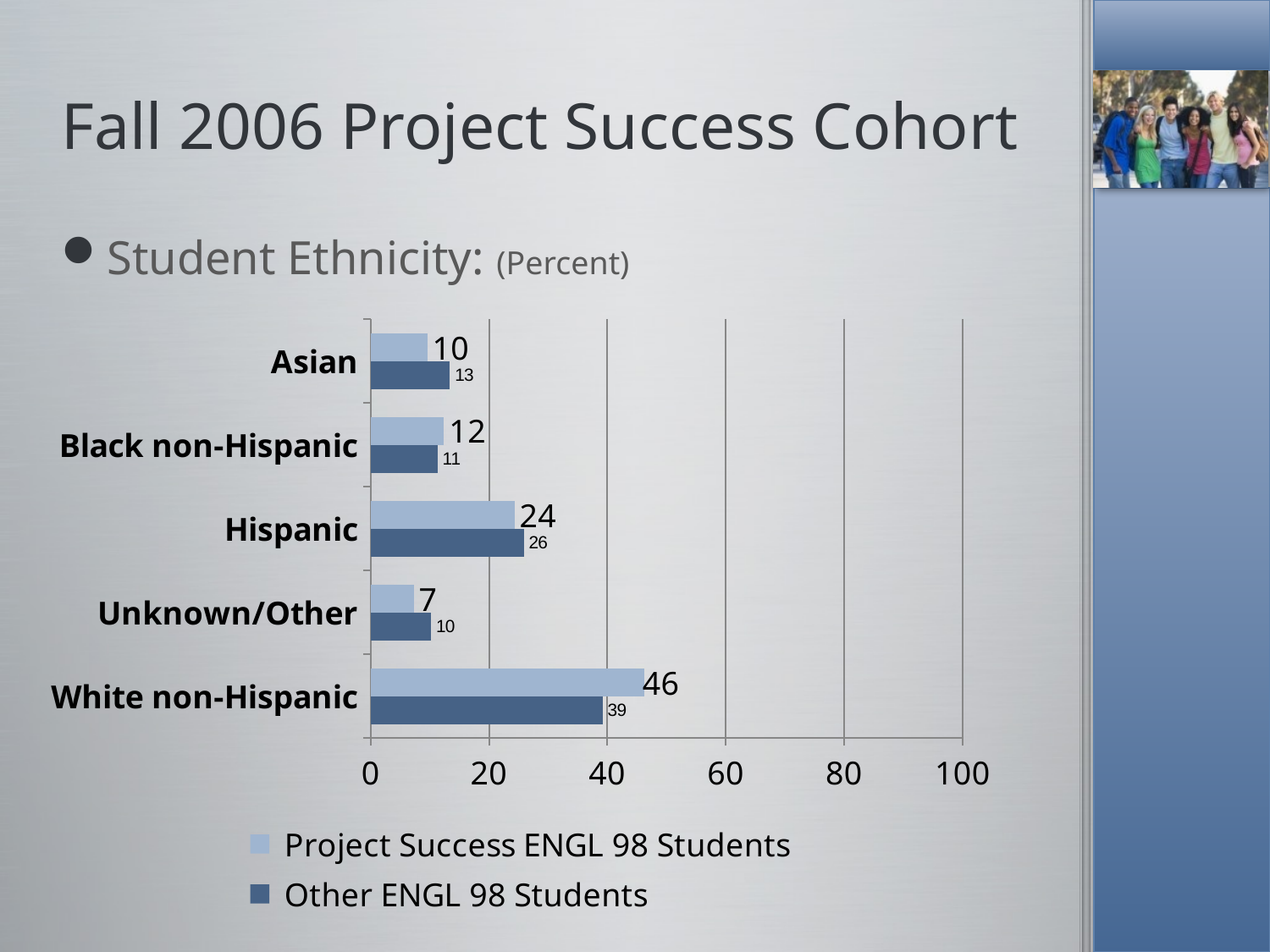
Is the value for Other ENGL 98 Students in the White non-Hispanic category greater or less than 40? less What is the value for Other ENGL 98 Students in the Asian category? 13 How many series does the legend list? 2 What is the value for Other ENGL 98 Students in the Hispanic category? 26 Which is larger for the Asian category: Project Success ENGL 98 Students or Other ENGL 98 Students? Other ENGL 98 Students How many ethnicity categories are shown in the chart? 5 What is the value for Project Success ENGL 98 Students in the Unknown/Other category? 7 Which category has the highest value for Project Success ENGL 98 Students? White non-Hispanic What kind of chart is shown on the slide? Bar chart What is the value for Project Success ENGL 98 Students in the White non-Hispanic category? 46 What is the difference between the Project Success ENGL 98 Students and Other ENGL 98 Students values for White non-Hispanic? 7 Which category has the lowest value for Other ENGL 98 Students? Unknown/Other